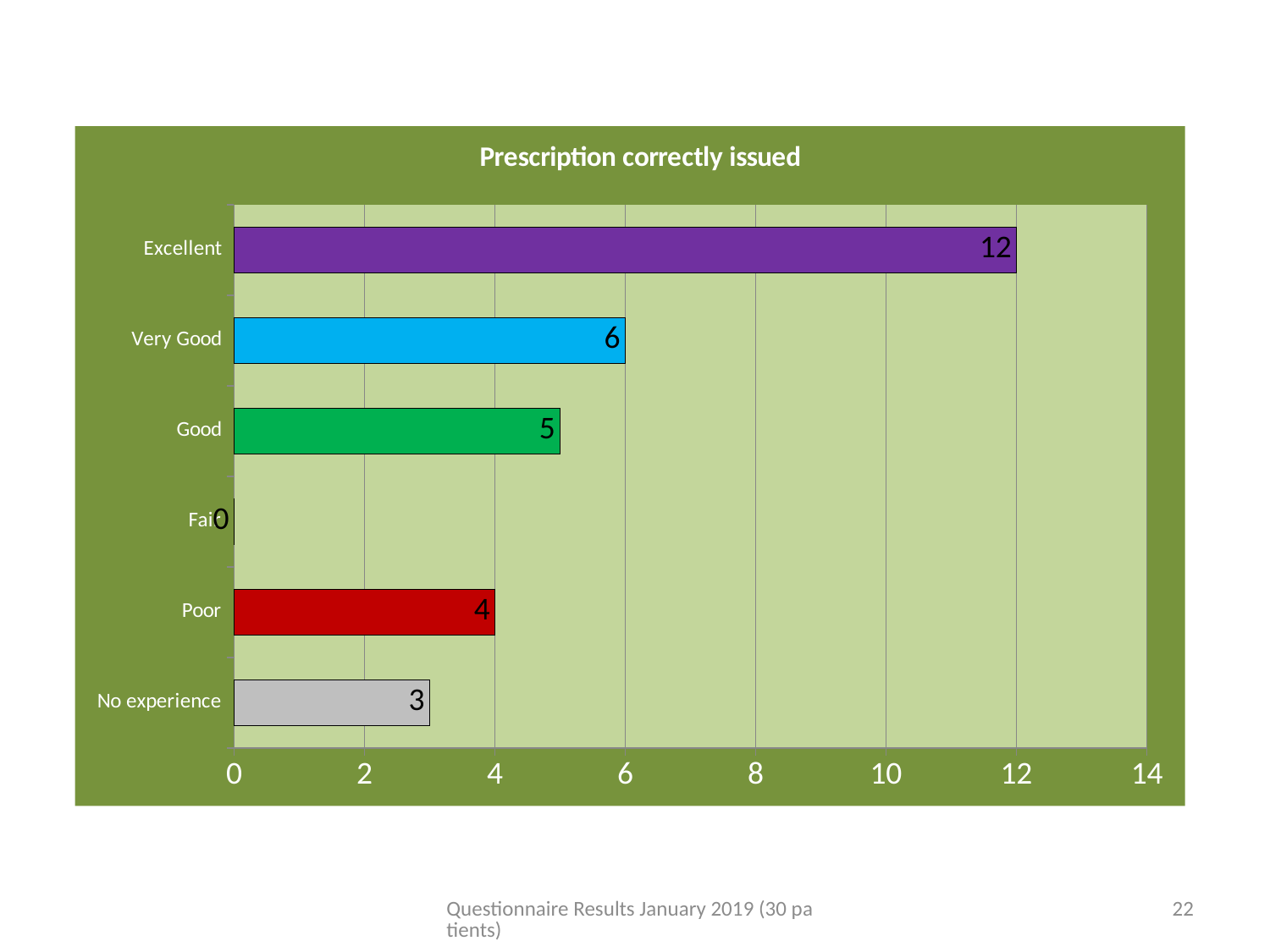
What is the value for Poor? 4 Which category has the highest value? Excellent Is the value for Excellent greater or less than 10? greater What is the value for No experience? 3 What is the difference between the values for Excellent and Very Good? 6 Which category has the lowest value? Fair Which is larger, the value for Good or the value for Poor? Good How many categories are shown in the chart? 6 What is the title of the chart? Prescription correctly issued What kind of chart is this? bar chart What is the value for Very Good? 6 What is the value for Excellent? 12